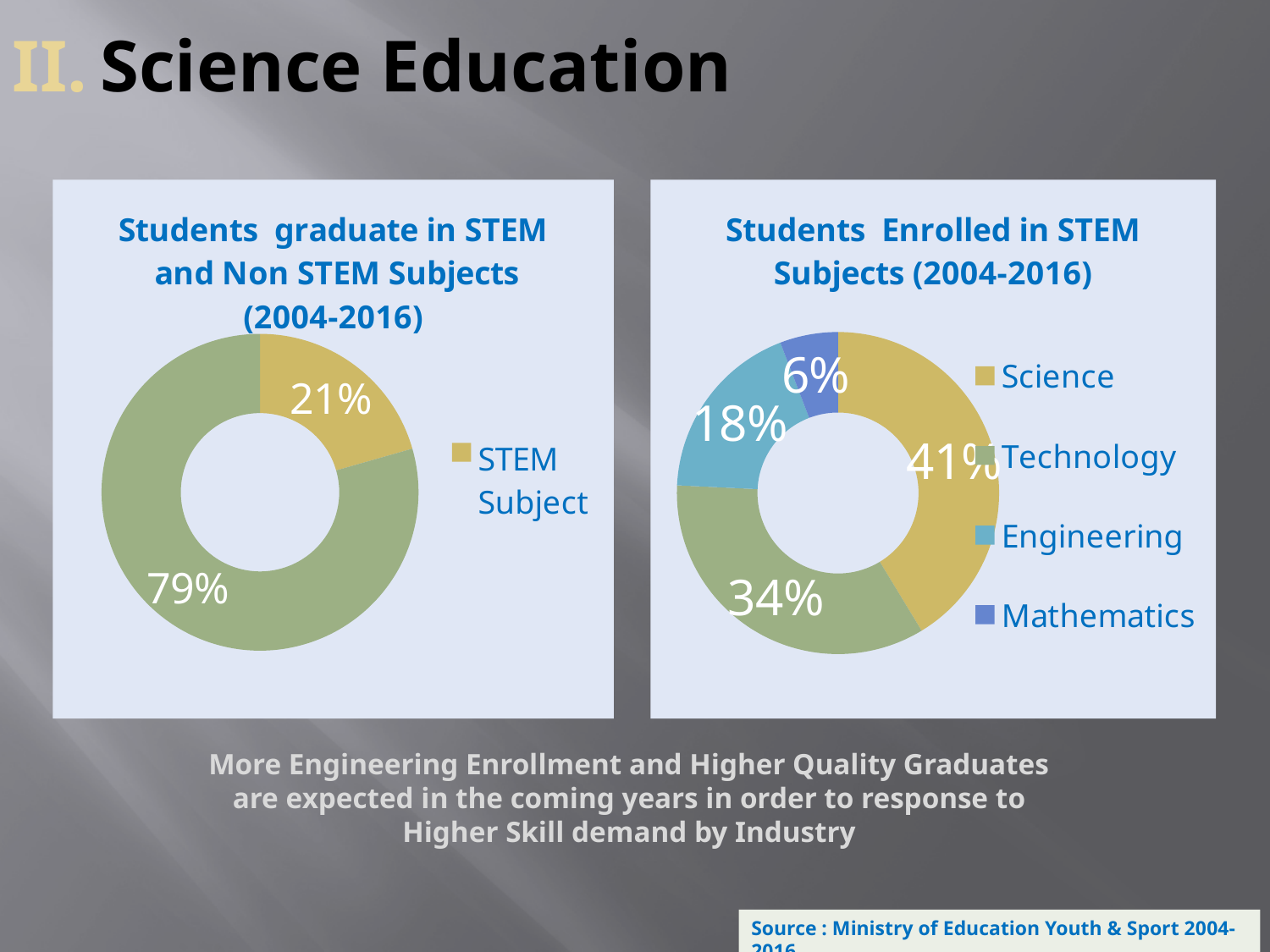
In the chart titled 'Students graduate in STEM and Non STEM Subjects (2004-2016)', what is the percentage shown on the largest slice? 79% In the chart titled 'Students graduate in STEM and Non STEM Subjects (2004-2016)', what percentage is shown for STEM Subject? 21% In the chart titled 'Students Enrolled in STEM Subjects (2004-2016)', what colour represents Mathematics? Blue In the chart titled 'Students Enrolled in STEM Subjects (2004-2016)', what is the difference in percentage points between Science and Technology? 7 In the chart titled 'Students Enrolled in STEM Subjects (2004-2016)', what percentage is shown for Mathematics? 6% In the chart titled 'Students Enrolled in STEM Subjects (2004-2016)', which subject has the smallest share? Mathematics How many categories does the legend list in the chart titled 'Students Enrolled in STEM Subjects (2004-2016)'? 4 In the chart titled 'Students Enrolled in STEM Subjects (2004-2016)', which has a larger share, Engineering or Technology? Technology In the chart titled 'Students Enrolled in STEM Subjects (2004-2016)', what percentage is shown for Engineering? 18% In the chart titled 'Students Enrolled in STEM Subjects (2004-2016)', what percentage is shown for Science? 41% What kind of chart is the chart titled 'Students graduate in STEM and Non STEM Subjects (2004-2016)'? Doughnut (pie) chart In the chart titled 'Students Enrolled in STEM Subjects (2004-2016)', which subject has the largest share? Science